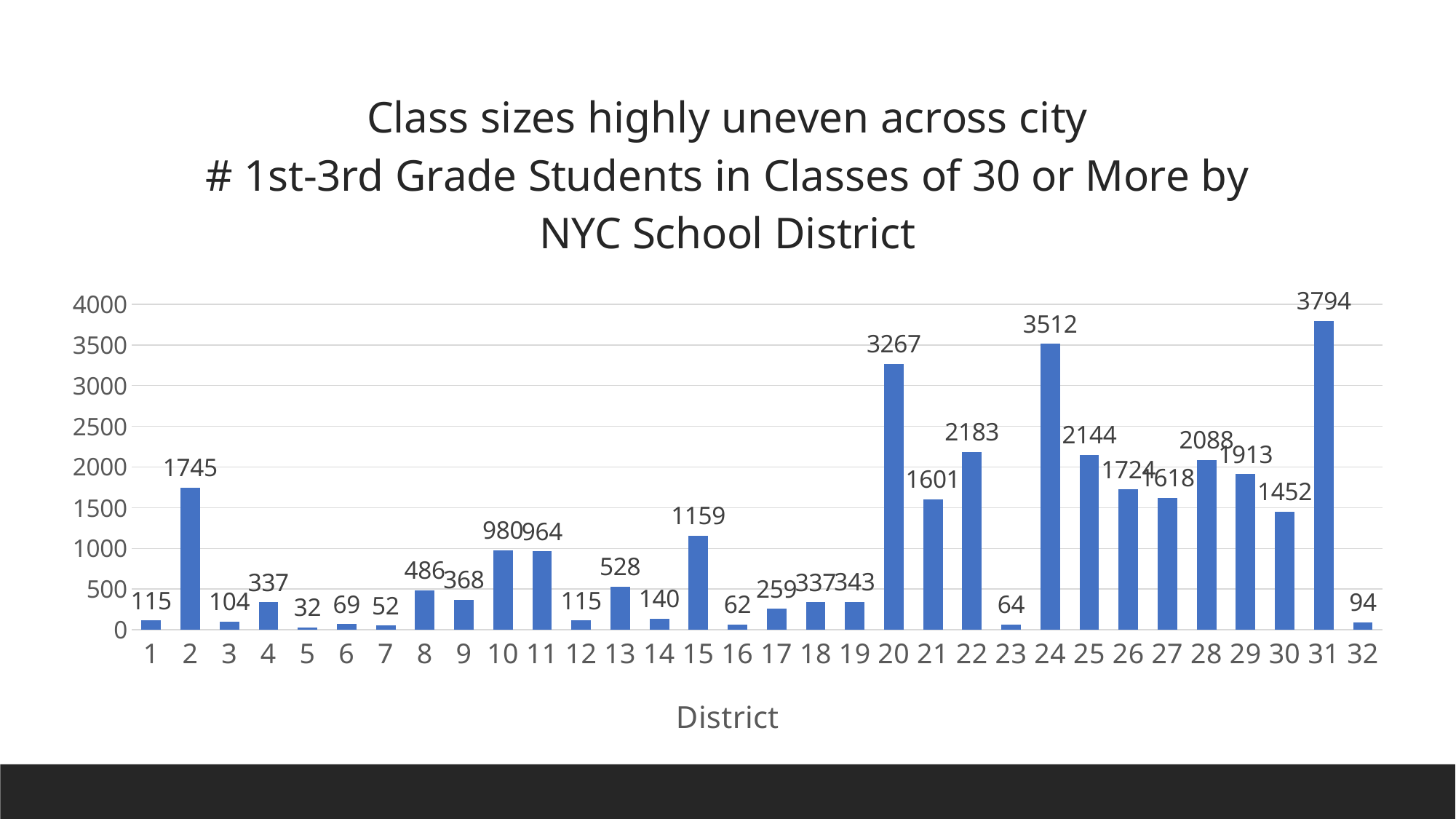
Which district has the lowest number of students in classes of 30 or more? 5 What is the value shown for District 2? 1745 How many districts are shown on the x axis? 32 What is the difference between the values for District 31 and District 24? 282 What is the difference between the values for District 22 and District 21? 582 Which has a larger value, District 25 or District 26? District 25 What is the label of the x axis? District What is the value shown for District 15? 1159 What kind of chart is shown on the slide? Bar chart Which district has the highest number of students in classes of 30 or more? 31 How many 1st-3rd grade students in classes of 30 or more are shown for District 20? 3267 Is the value for District 29 greater or less than 1500? greater